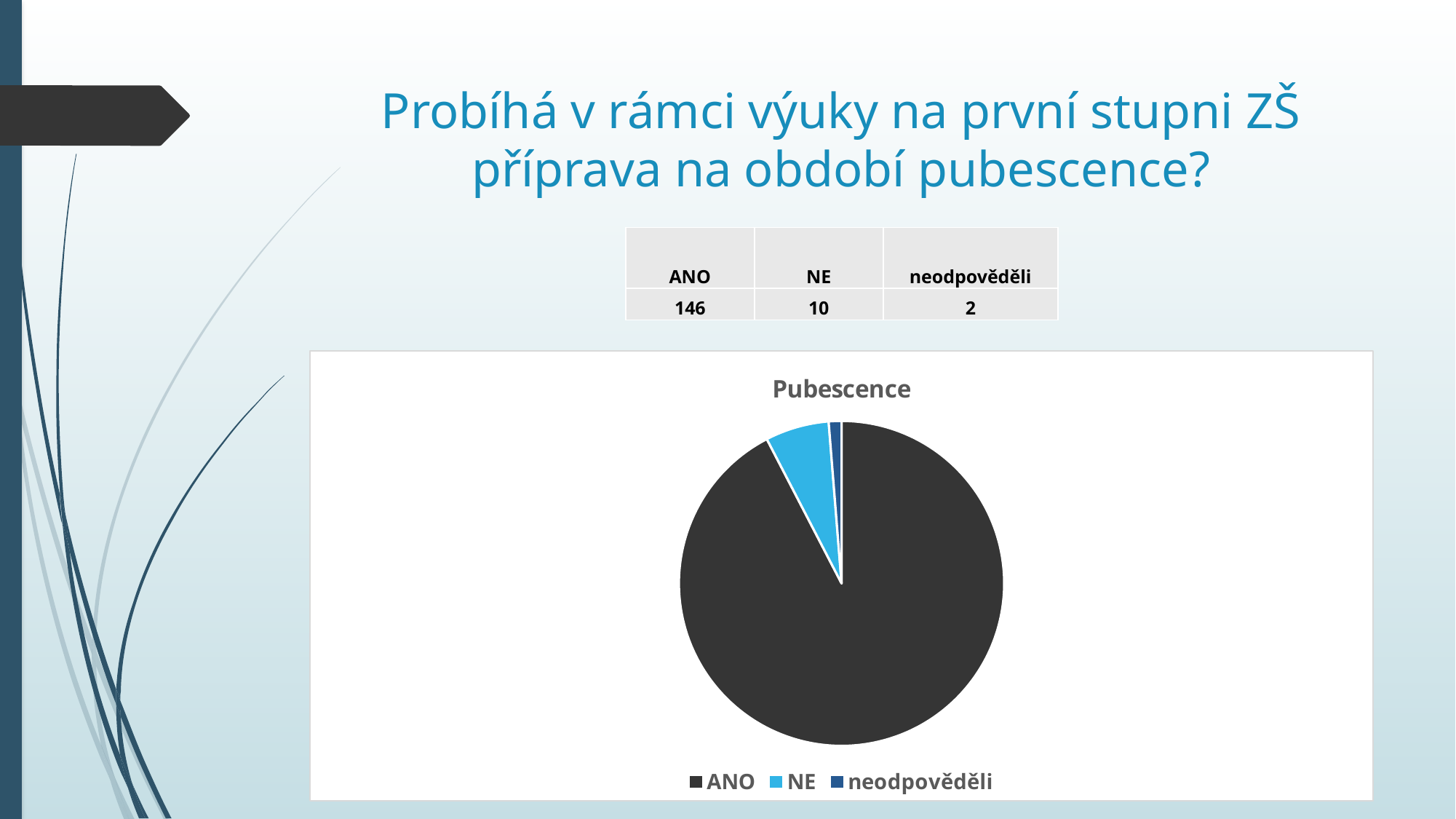
Which is larger, the value for NE or the value for neodpověděli? NE Which category has the smallest slice of the pie? neodpověděli What is the total of all three categories in the pie chart? 158 What is the value for neodpověděli? 2 What is the value for NE? 10 How many slices does the pie chart have? 3 Which category has the largest slice of the pie? ANO What is the title of the chart? Pubescence What is the difference between the values for ANO and NE? 136 What is the value for ANO? 146 How many entries does the chart legend list? 3 What kind of chart is shown on the slide? pie chart